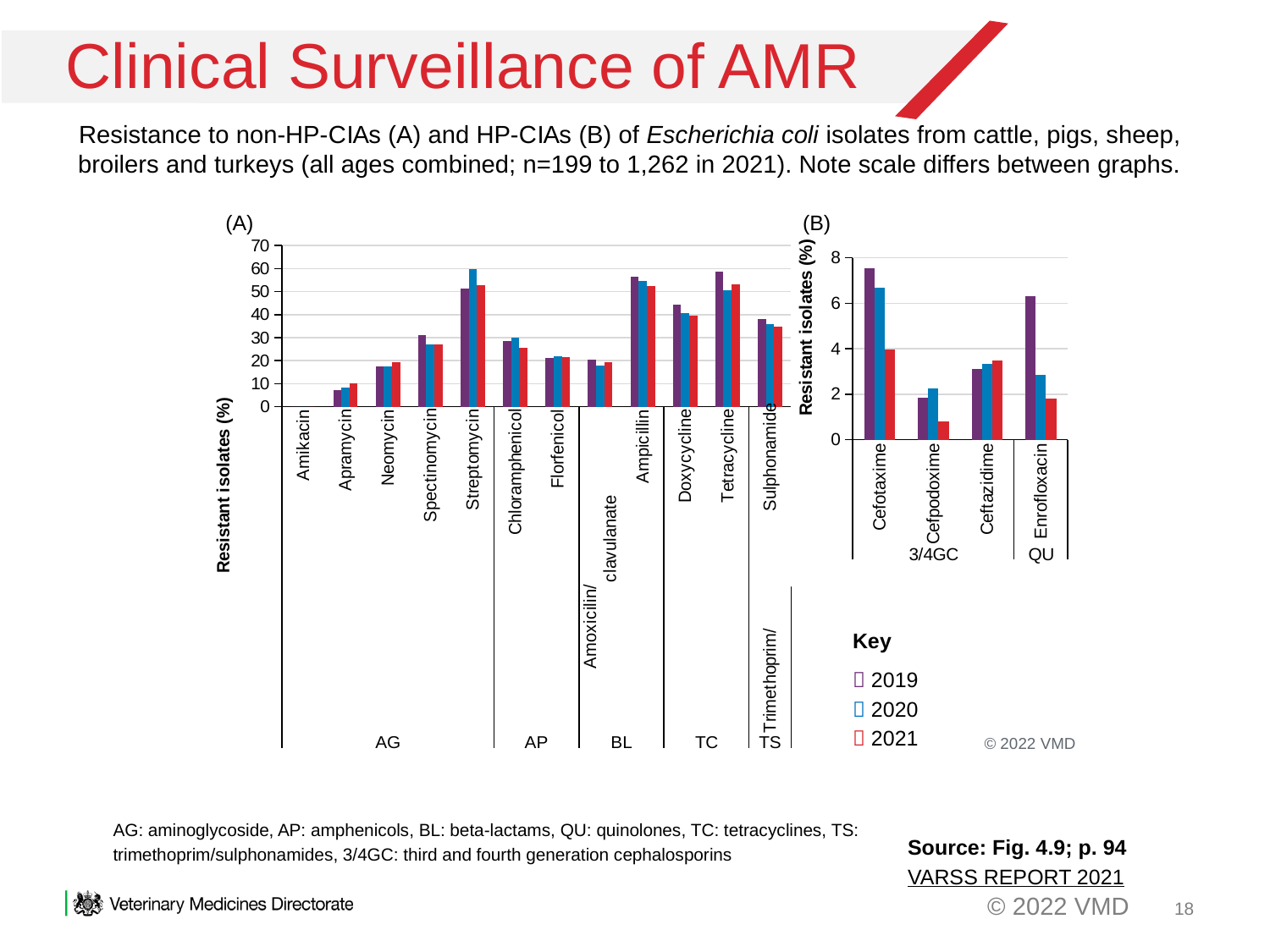
How many series does the key list for the charts? 3 In chart (B), which antimicrobial has the highest 2019 value? Cefotaxime How many antimicrobials are shown on the x axis of chart (B)? 4 In chart (B), is the 2019 value for Cefotaxime greater or less than 6? greater In chart (B), which antimicrobial has the lowest 2021 value? Cefpodoxime In chart (B), do the values for Enrofloxacin rise or fall from 2019 to 2021? fall What is the y-axis label on chart (B)? Resistant isolates (%) In chart (B), which is larger for 2021: Cefotaxime or Enrofloxacin? Cefotaxime In chart (A), which antimicrobial has the highest 2020 value? Streptomycin What kind of chart is chart (A)? bar chart In chart (A), is the 2019 value for Neomycin greater or less than 20? less In chart (A), is the 2020 value for Streptomycin greater or less than 50? greater